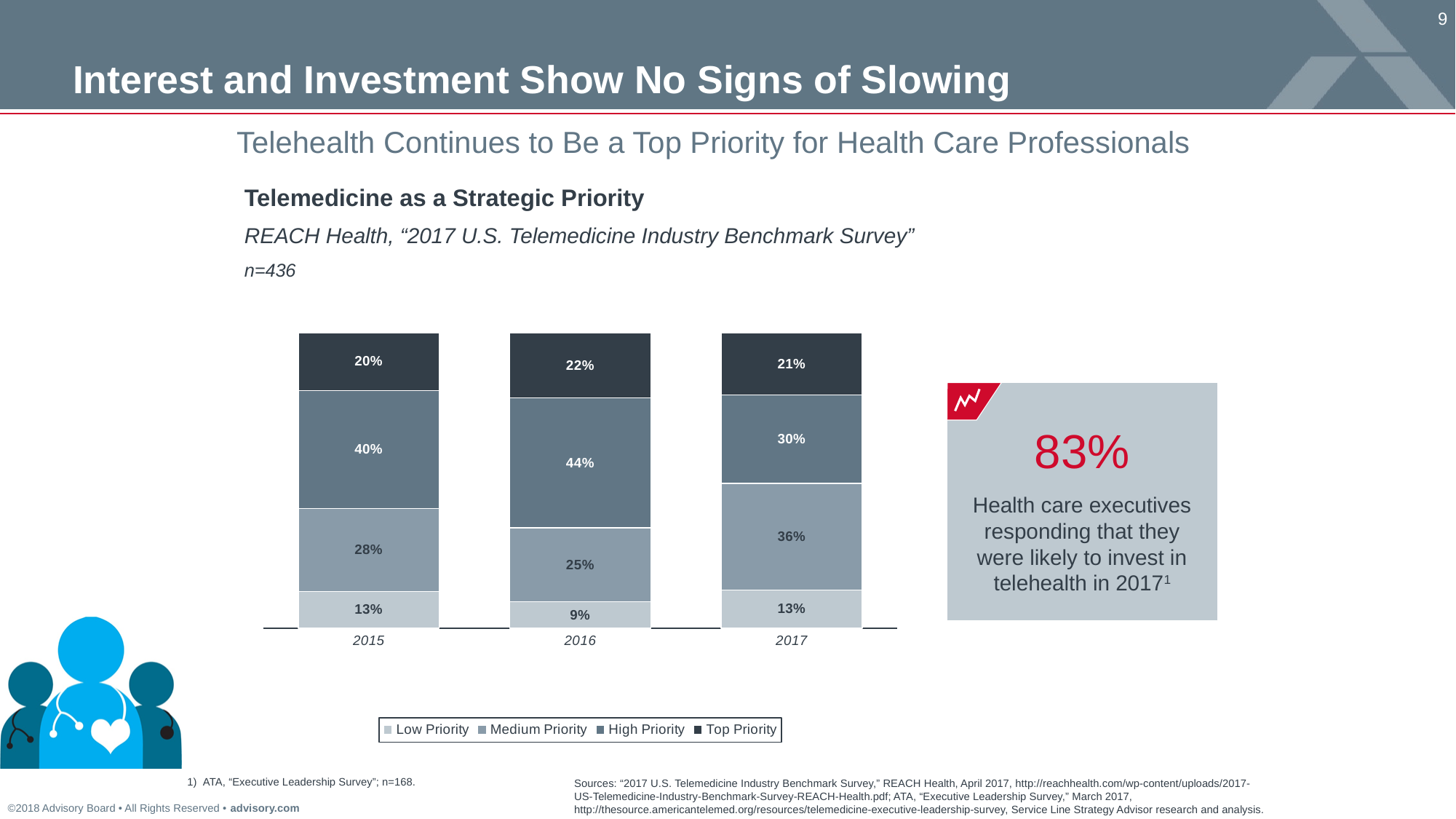
What is the total of the stacked bar for 2017? 100% By how many percentage points did the Medium Priority share change from 2015 to 2017? 8 percentage points How many series does the chart legend list? 4 In which year is the Top Priority share the highest? 2016 What percentage of respondents rated telemedicine as a High Priority in 2016? 44% What type of chart is used to show telemedicine as a strategic priority? Stacked bar chart What is the Low Priority value for 2016? 9% Which year has the larger High Priority share, 2015 or 2017? 2015 Does the High Priority share rise or fall from 2016 to 2017? Fall In which year is the Low Priority share the lowest? 2016 How many years are shown on the x axis of the chart? 3 What is the Medium Priority value for 2017? 36%